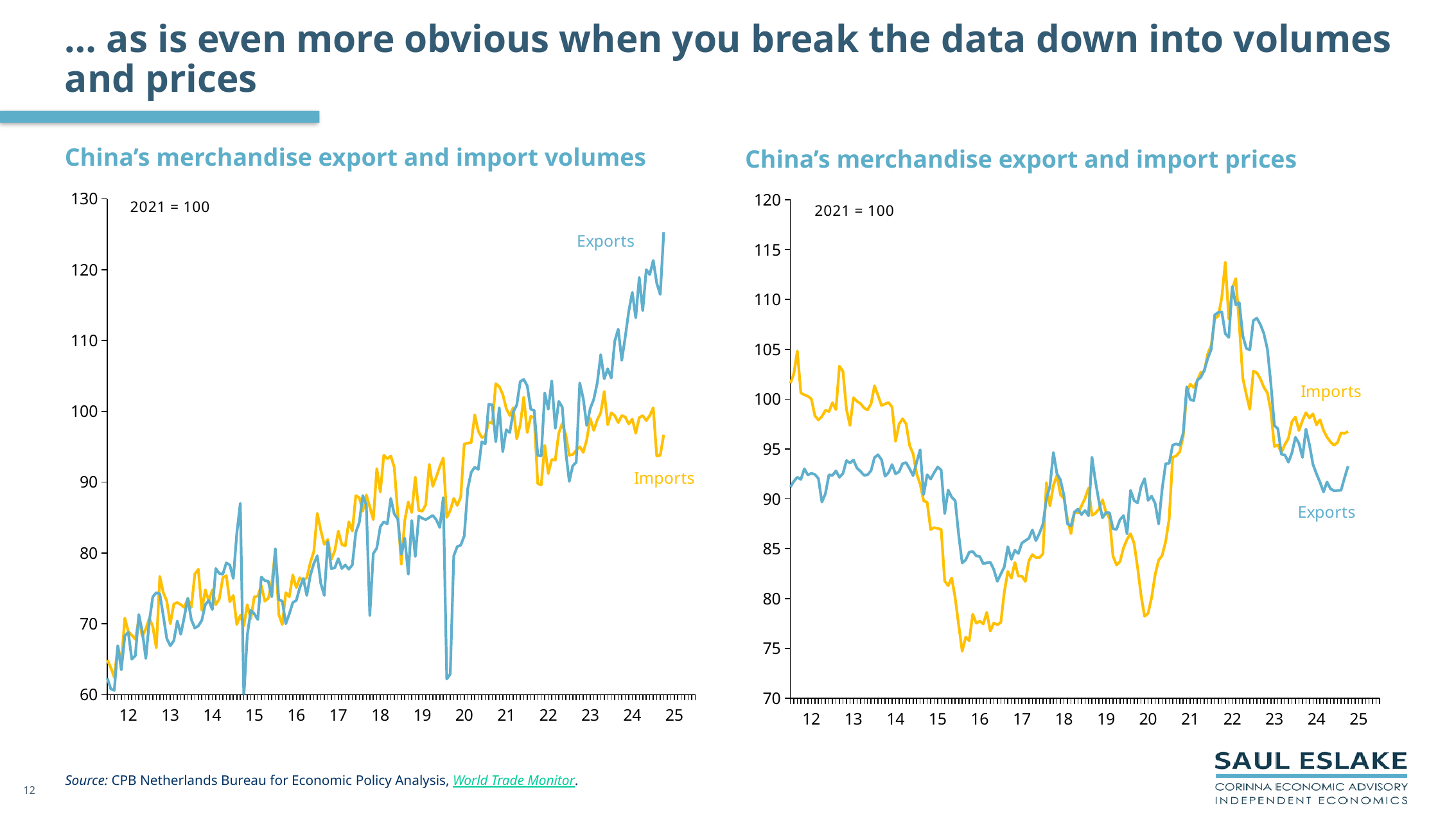
On the 'China's merchandise export and import volumes' chart, is the latest value for Exports greater or less than 120? greater What is the source cited for the charts on the slide? CPB Netherlands Bureau for Economic Policy Analysis, World Trade Monitor On the 'China's merchandise export and import prices' chart, is the latest value for Exports greater or less than 95? less How many series are plotted on the 'China's merchandise export and import prices' chart? 2 What kind of chart is the 'China's merchandise export and import volumes' chart? line chart On the 'China's merchandise export and import volumes' chart, does the Exports series generally rise or fall from 2012 to 2025? rise On the 'China's merchandise export and import volumes' chart, which year is set equal to 100? 2021 On the 'China's merchandise export and import volumes' chart, which series is higher at the end of the period, Exports or Imports? Exports On the 'China's merchandise export and import volumes' chart, is the latest value for Imports greater or less than 100? less On the 'China's merchandise export and import prices' chart, which series is higher at the end of the period, Exports or Imports? Imports